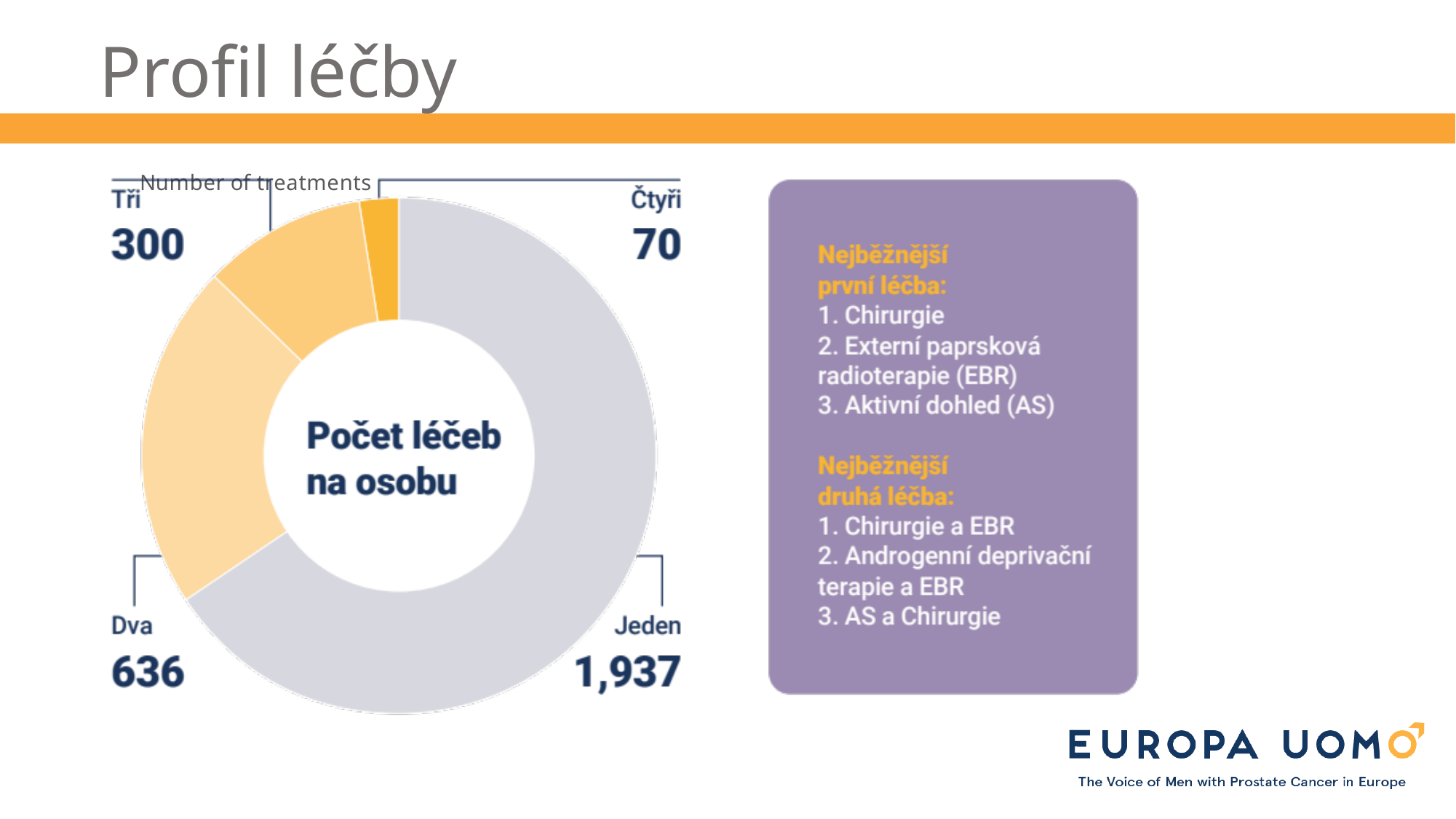
What is the total of all four segment values in the donut chart? 2,943 What is the difference between the values for "Dva" and "Tři" in the donut chart? 336 What text is written in the centre of the donut chart? Počet léčeb na osobu What is the value for the "Jeden" segment of the donut chart? 1,937 What is the value for the "Dva" segment of the donut chart? 636 How many segments does the donut chart have? 4 Which category has the smallest value in the donut chart? Čtyři What kind of chart is shown on the slide? Donut (pie) chart Which is larger in the donut chart, the value for "Tři" or the value for "Čtyři"? Tři What is the value for the "Tři" segment of the donut chart? 300 Which category has the largest value in the donut chart? Jeden What is the value for the "Čtyři" segment of the donut chart? 70